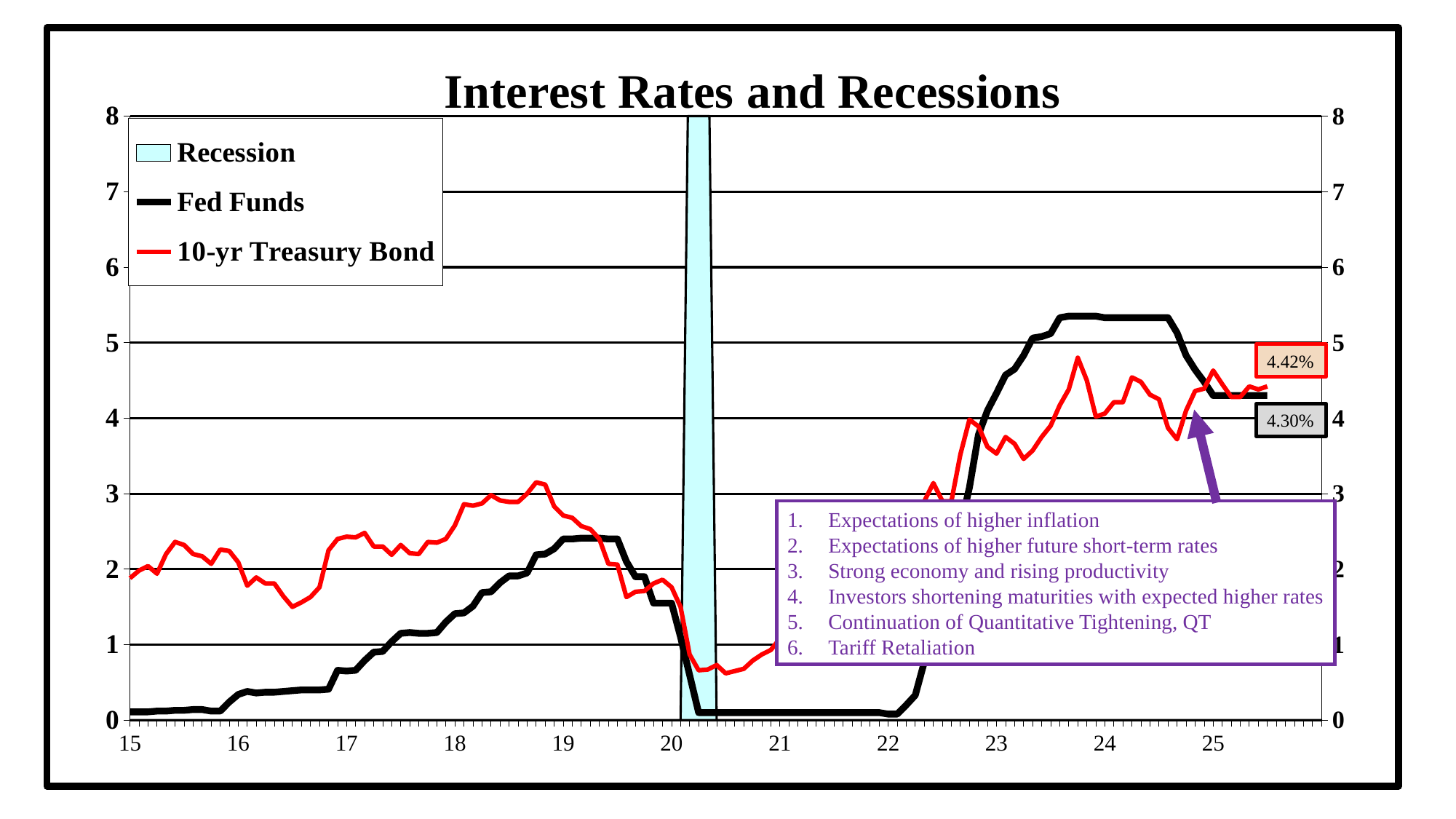
What is the difference between the labelled 10-yr Treasury Bond value (4.42%) and the labelled Fed Funds value (4.30%)? 0.12% What kind of chart is shown on the slide? Line chart What colour is the Fed Funds line? Black At the end of the chart, which is higher: the 10-yr Treasury Bond or Fed Funds? 10-yr Treasury Bond Is the Fed Funds rate at its 2024 plateau greater or less than 5? greater What is the latest labelled value for Fed Funds? 4.30% What is the latest labelled value for the 10-yr Treasury Bond? 4.42% Is the 10-yr Treasury Bond rate during 2016 greater or less than 3? less Is the Fed Funds rate during 2021 greater or less than 1? less How many entries does the chart's legend list? 3 Does the Fed Funds rate rise or fall between 2022 and 2023? Rise What is the title of the chart? Interest Rates and Recessions